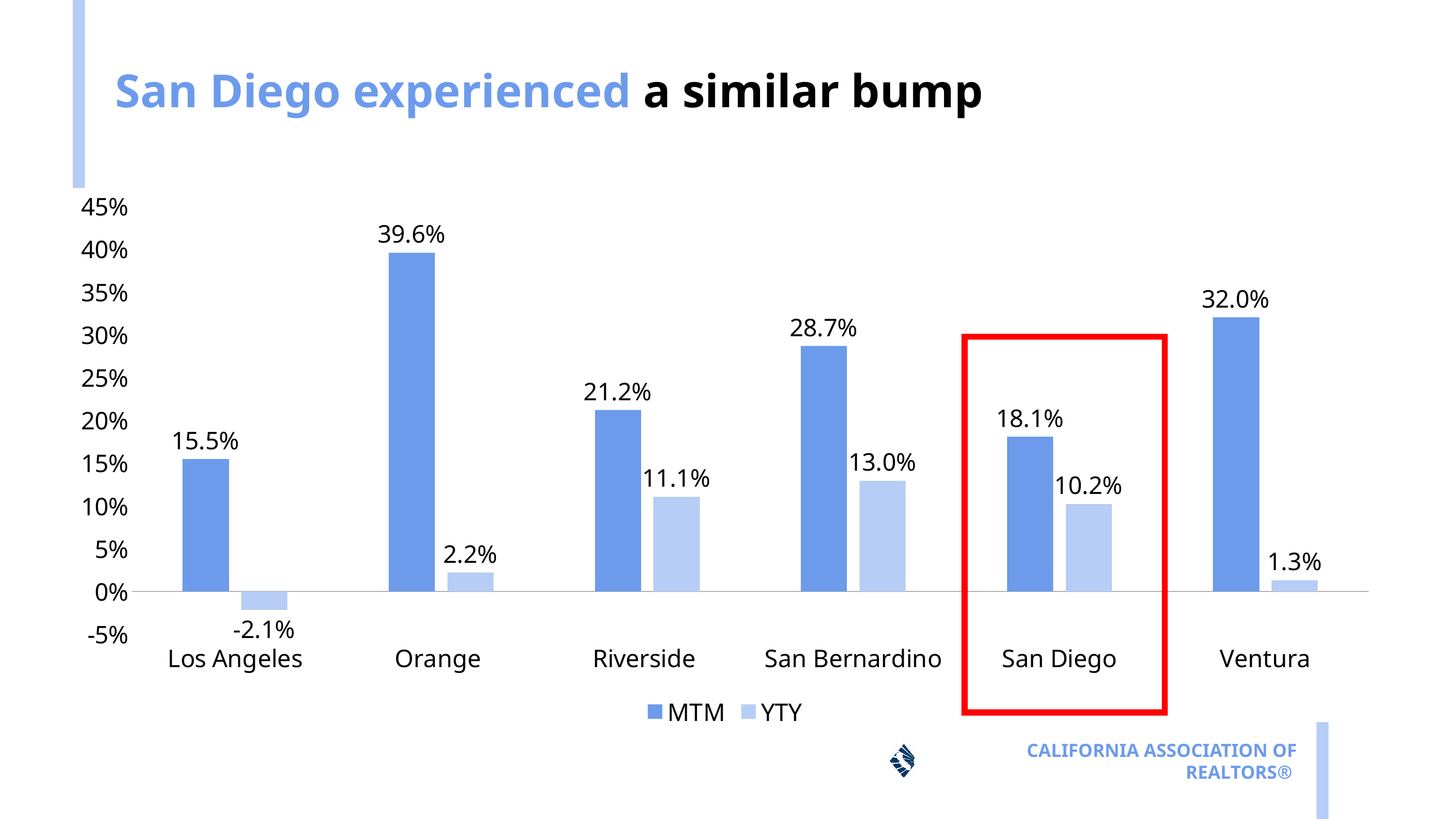
Which county has the lowest YTY value? Los Angeles Is the MTM value for Riverside greater or less than 20%? greater What kind of chart is shown on the slide? Bar chart How many counties are shown on the x axis? 6 How many series does the legend list? 2 Which is larger, the MTM value for Ventura or the MTM value for San Bernardino? Ventura What is the MTM value for San Diego? 18.1% Which county has the highest MTM value? Orange What is the difference between the MTM and YTY values for San Diego? 7.9% What is the YTY value for Los Angeles? -2.1% Which county is highlighted with a red box on the chart? San Diego What is the YTY value for San Bernardino? 13.0%